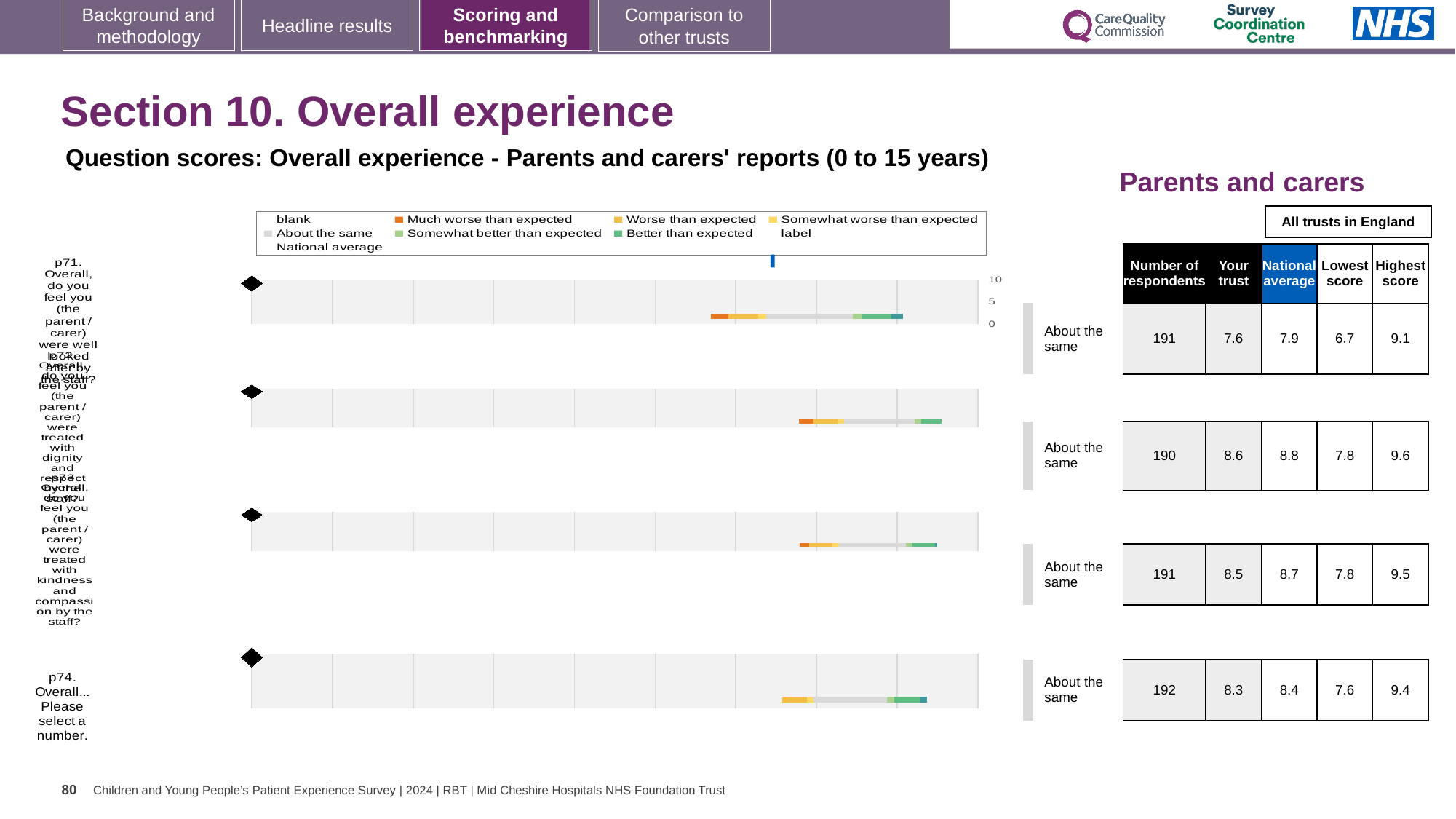
Which row in the table has the highest 'Your trust' score? the second row (8.6) In the table next to the chart, what is the 'Your trust' score for p74 (Overall... Please select a number)? 8.3 In the table next to the chart, how many respondents answered p74 (Overall... Please select a number)? 192 For p74, what is the difference between the national average and the 'Your trust' score? 0.1 What benchmark category is shown for every question in the chart? About the same In the table next to the chart, what is the 'Your trust' score for the first row (p71)? 7.6 What kind of chart is used to show the question scores on this slide? bar chart In the table next to the chart, what is the lowest score for the first row (p71)? 6.7 In the table next to the chart, what is the highest score for p74 (Overall... Please select a number)? 9.4 In the table next to the chart, what is the national average for p74 (Overall... Please select a number)? 8.4 How many questions (rows) are plotted in the benchmarking chart? 4 For p74, which is larger: the 'Your trust' score or the national average? national average